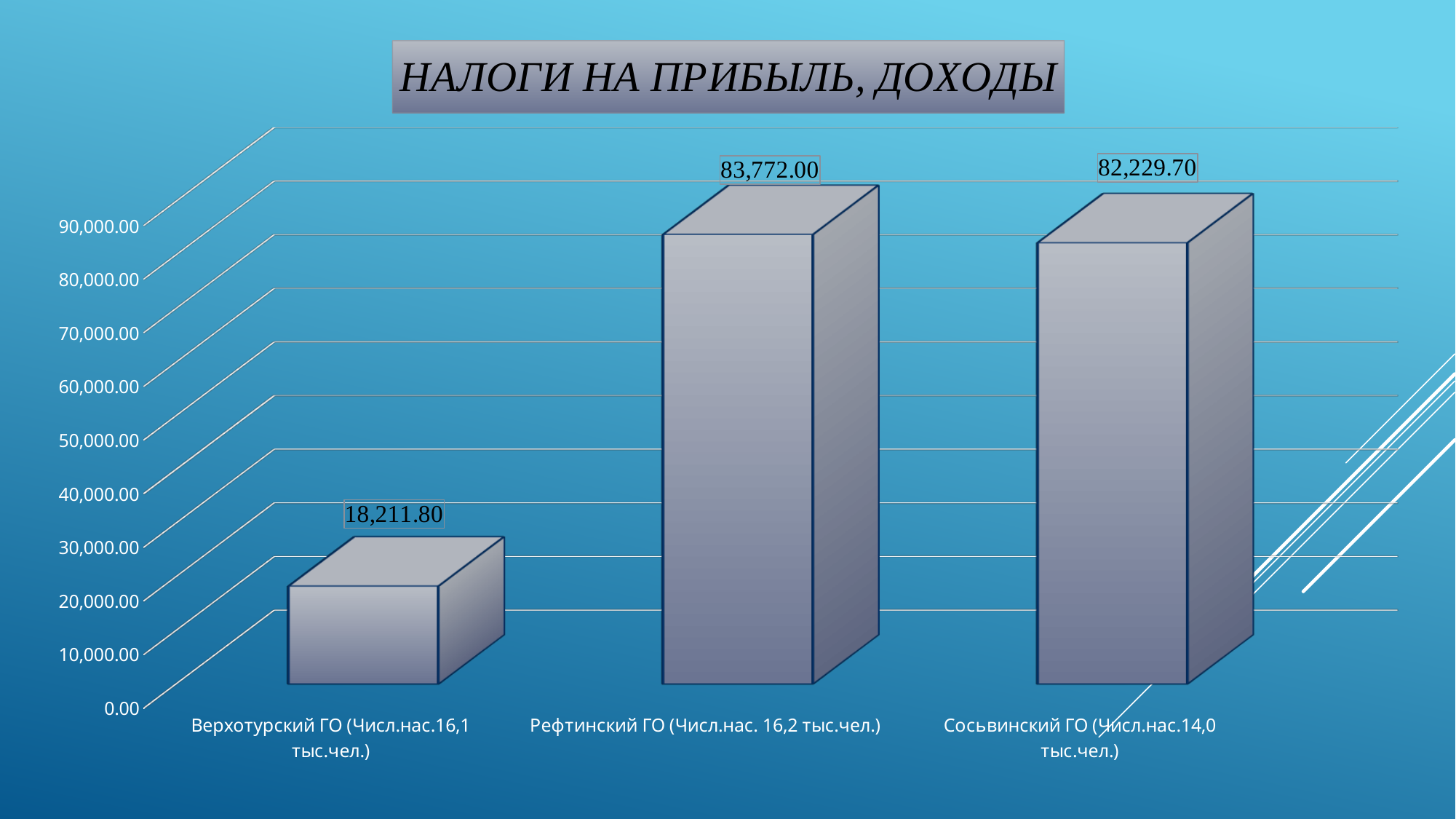
Which is larger, the value for Сосьвинский ГО or the value for Верхотурский ГО? Сосьвинский ГО What is the value for Сосьвинский ГО? 82,229.70 What is the difference between the values for Рефтинский ГО and Верхотурский ГО? 65,560.20 What is the difference between the values for Рефтинский ГО and Сосьвинский ГО? 1,542.30 Which category has the highest value? Рефтинский ГО How many categories are shown in the chart? 3 What is the value for Рефтинский ГО? 83,772.00 Is the value for Верхотурский ГО greater or less than 20,000.00? less What is the value for Верхотурский ГО? 18,211.80 Which category has the lowest value? Верхотурский ГО What kind of chart is shown on the slide? bar chart What is the title of the chart? НАЛОГИ НА ПРИБЫЛЬ, ДОХОДЫ